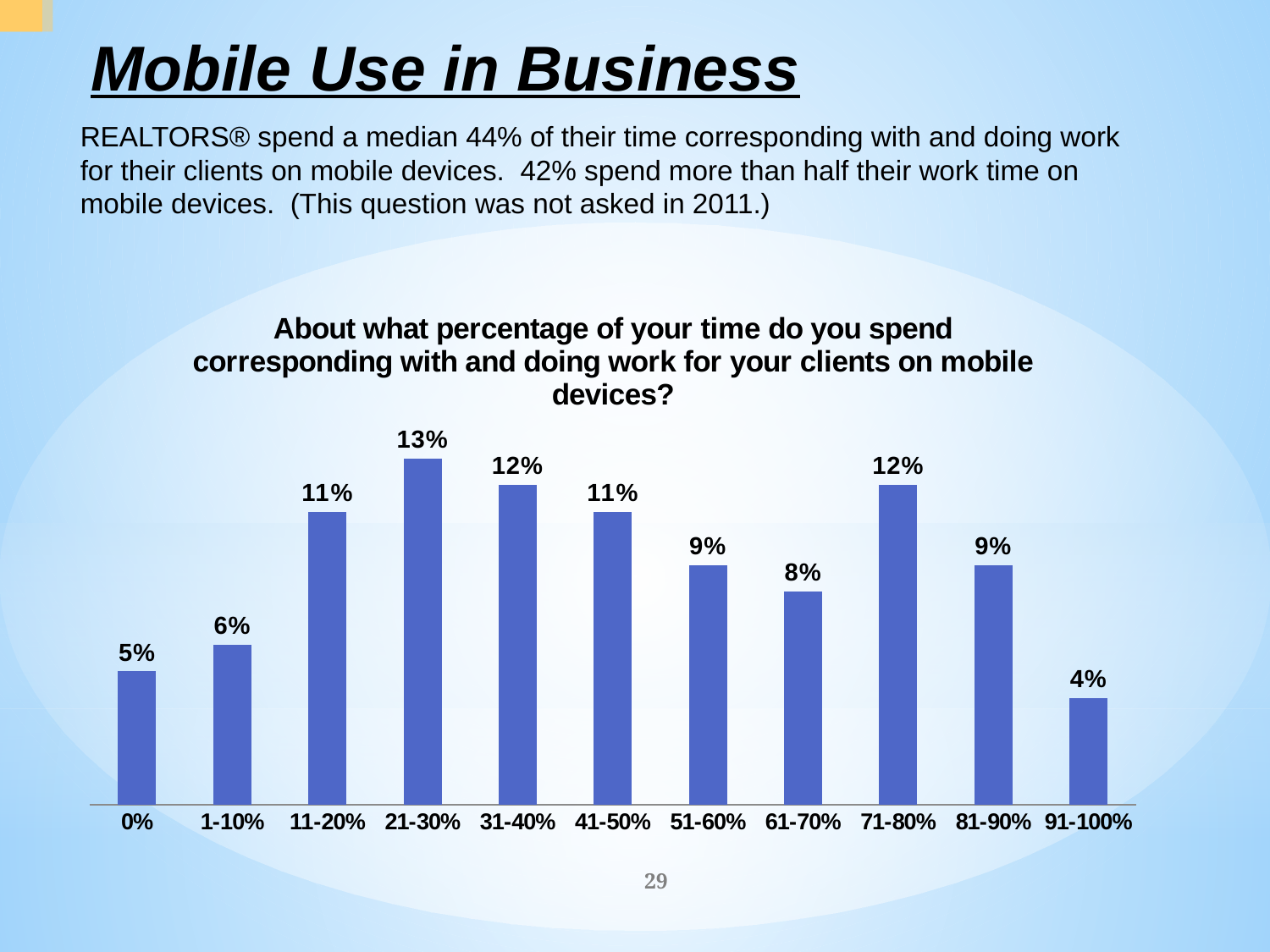
What is the value for the 0% category? 5% What is the value for the 91-100% category? 4% What kind of chart is shown on the slide? Bar chart Which category has the lowest value? 91-100% How many categories are shown on the x axis? 11 What percentage of respondents spend 21-30% of their time on mobile devices? 13% What is the difference between the values for 71-80% and 61-70%? 4% What is the value for the 61-70% category? 8% Which category has the highest value? 21-30% What is the difference between the values for 21-30% and 91-100%? 9% Do the values rise or fall from the 0% category to the 21-30% category? Rise Which is larger, the value for 1-10% or the value for 81-90%? 81-90%